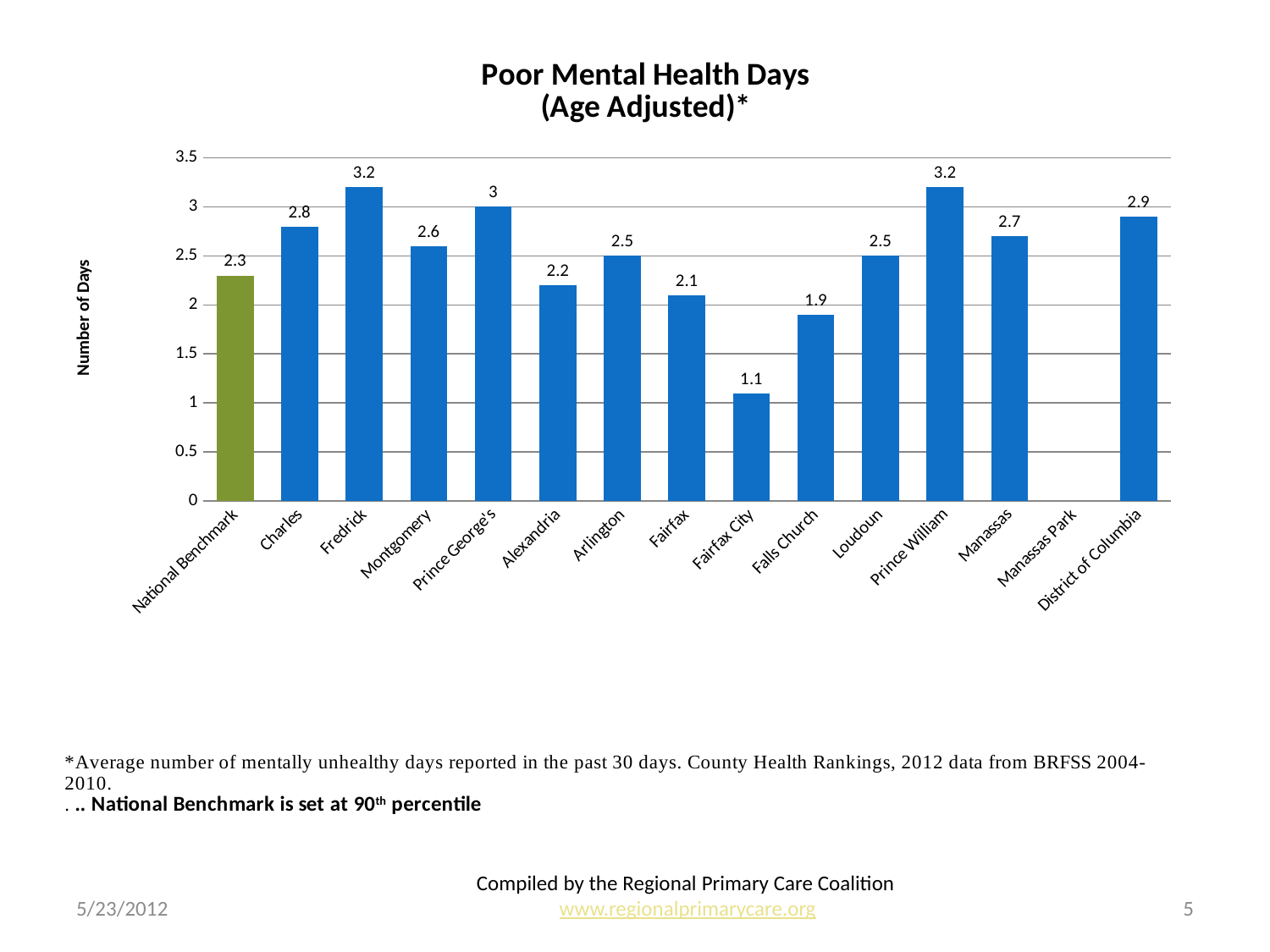
Which bar is coloured green rather than blue? National Benchmark What is the value for the National Benchmark bar? 2.3 What is the value for Fairfax City? 1.1 What is the title of the chart? Poor Mental Health Days (Age Adjusted)* What is the value for Charles? 2.8 Is the value for Falls Church greater or less than 2? less What is the difference between the values for Fredrick and Montgomery? 0.6 What is the value for District of Columbia? 2.9 Which is larger, the value for Manassas or the value for Loudoun? Manassas Which category has the lowest bar on the chart? Fairfax City How many categories are labelled on the x axis? 15 What kind of chart is shown on the slide? bar chart